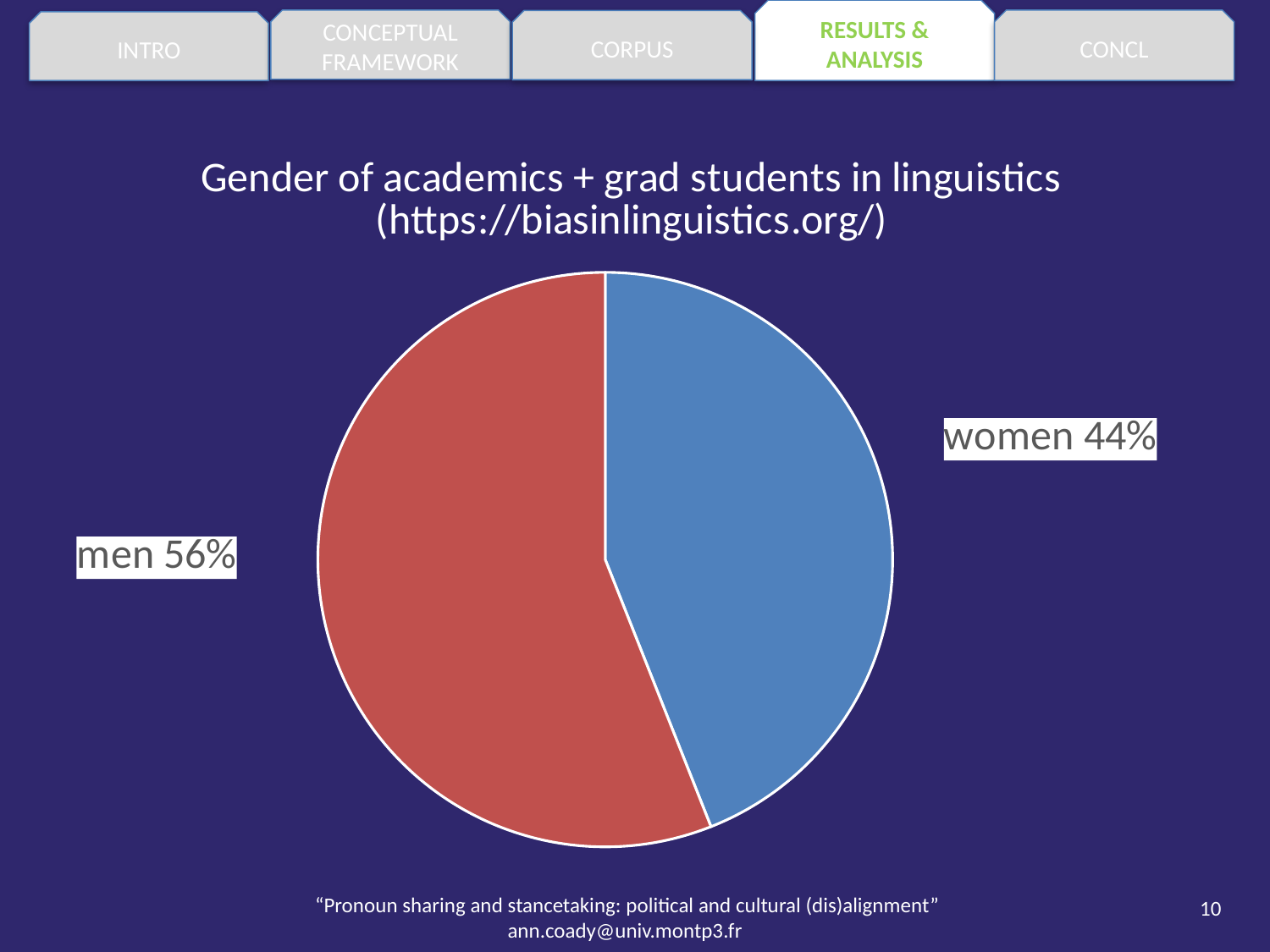
What type of chart is shown on the slide? pie chart What is the difference in percentage points between the men and women slices? 12 Which category has the largest slice of the pie? men What share of the pie is labelled for men? 56% How many slices does the pie chart have? 2 What is the title of the chart? Gender of academics + grad students in linguistics (https://biasinlinguistics.org/) What share of the pie is labelled for women? 44% Is the share for women greater or less than 50%? less Which category has the smallest slice of the pie? women What colour is the slice for men? red Which slice is larger, men or women? men